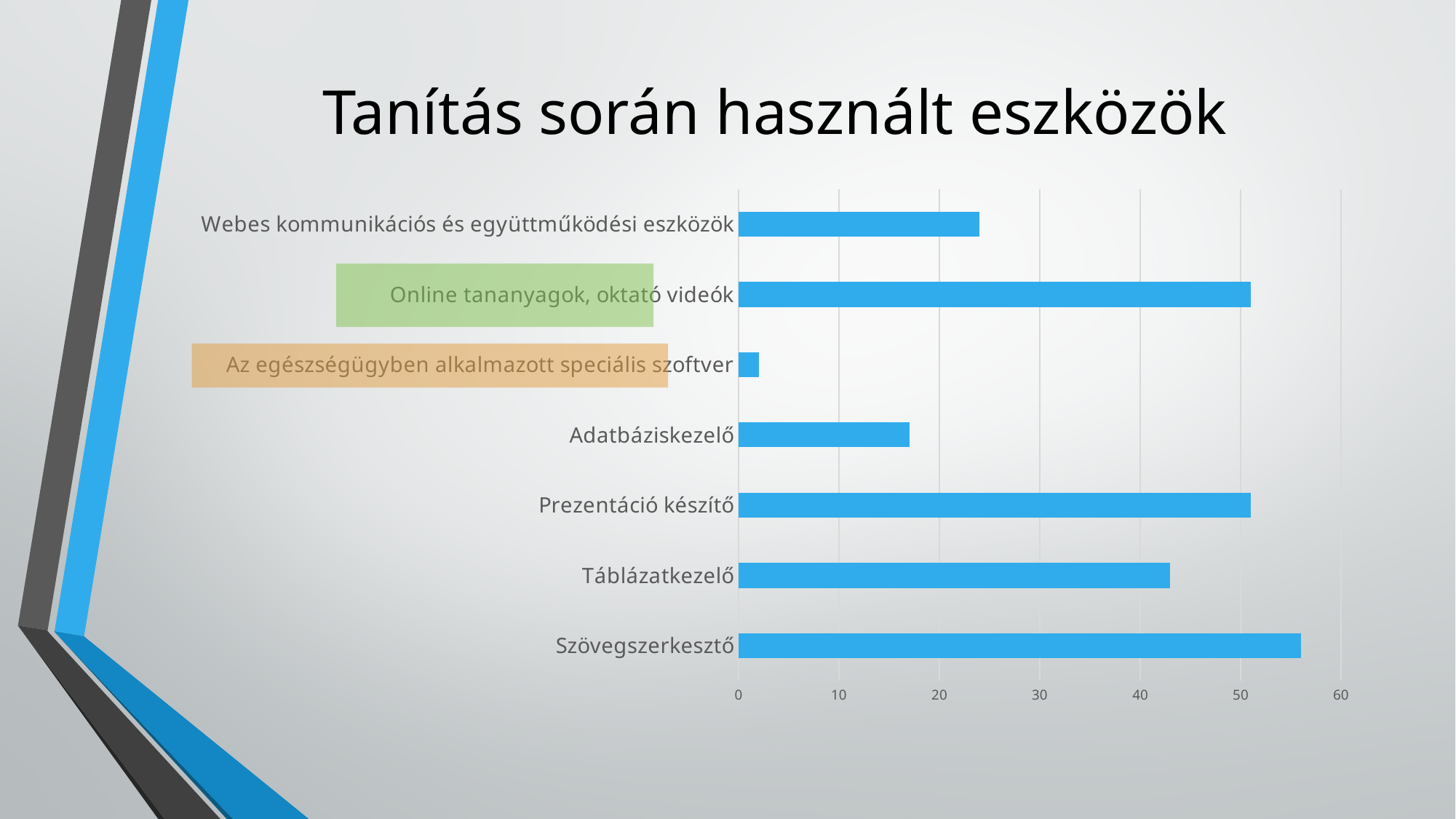
Which is larger, the value for Táblázatkezelő or the value for Prezentáció készítő? Prezentáció készítő Which category has the highest value? Szövegszerkesztő Which category has the lowest value? Az egészségügyben alkalmazott speciális szoftver Is the value for Táblázatkezelő greater or less than 40? greater How many categories are plotted in the chart? 7 What kind of chart is shown on the slide? bar chart Which is larger, the value for Webes kommunikációs és együttműködési eszközök or the value for Adatbáziskezelő? Webes kommunikációs és együttműködési eszközök Is the value for Webes kommunikációs és együttműködési eszközök greater or less than 20? greater Is the value for Az egészségügyben alkalmazott speciális szoftver greater or less than 10? less What is the title of the chart? Tanítás során használt eszközök What is the highest value shown on the horizontal axis? 60